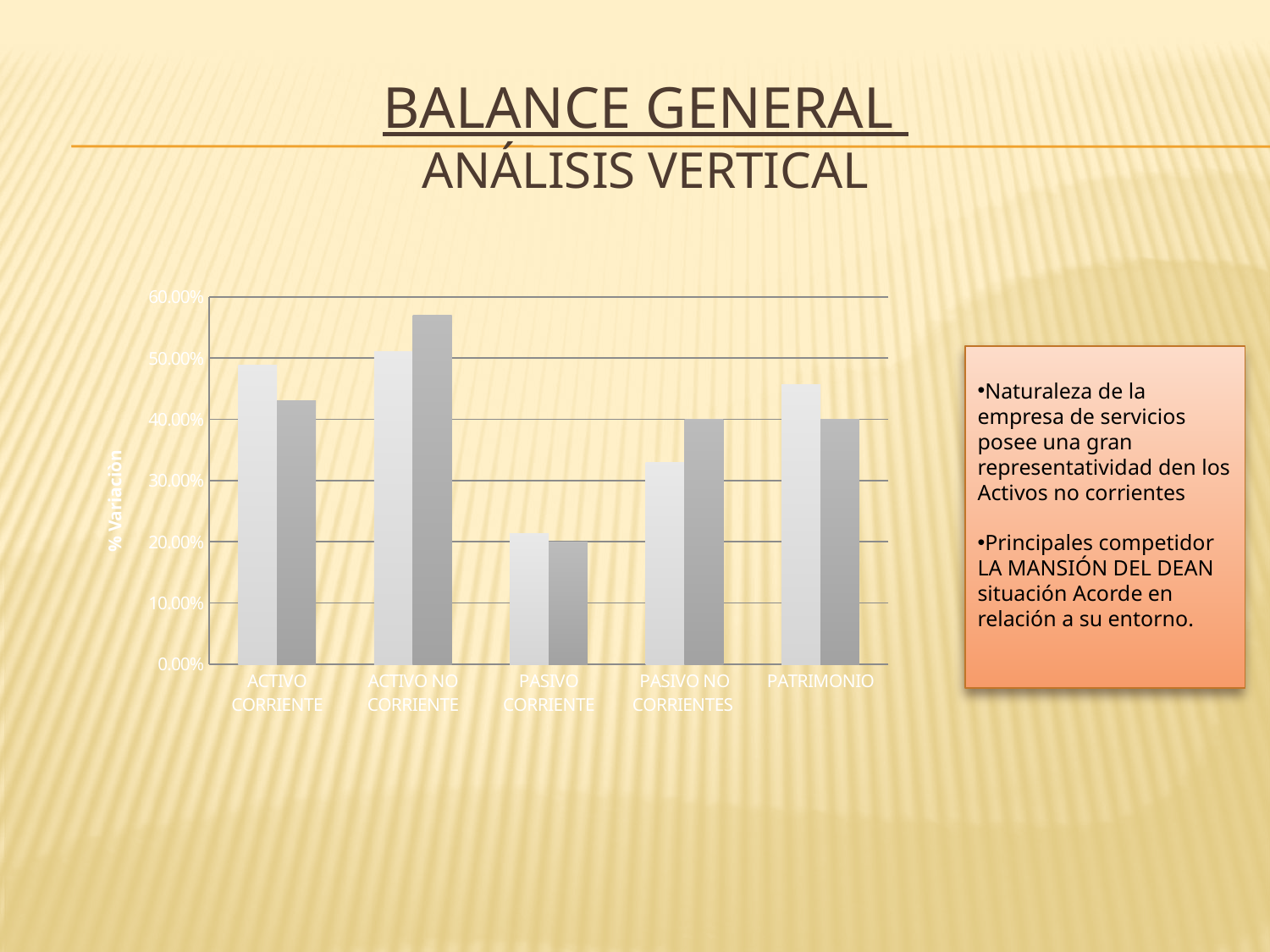
Which is larger: the lighter bar for ACTIVO CORRIENTE or the lighter bar for PASIVO CORRIENTE? ACTIVO CORRIENTE What kind of chart is shown on the slide? Bar chart How many bars are shown for each category in the chart? 2 Is the darker bar for PASIVO CORRIENTE greater or less than 30.00%? less Which category has the tallest bar in the chart? ACTIVO NO CORRIENTE What is the title of the vertical axis of the chart? % Variación Is the lighter bar for PASIVO NO CORRIENTES greater or less than 40.00%? less How many categories are shown on the x axis of the chart? 5 Is the darker bar for ACTIVO NO CORRIENTE greater or less than 50.00%? greater Which category has the shortest bars in the chart? PASIVO CORRIENTE Which is larger: the darker bar for ACTIVO NO CORRIENTE or the darker bar for PATRIMONIO? ACTIVO NO CORRIENTE